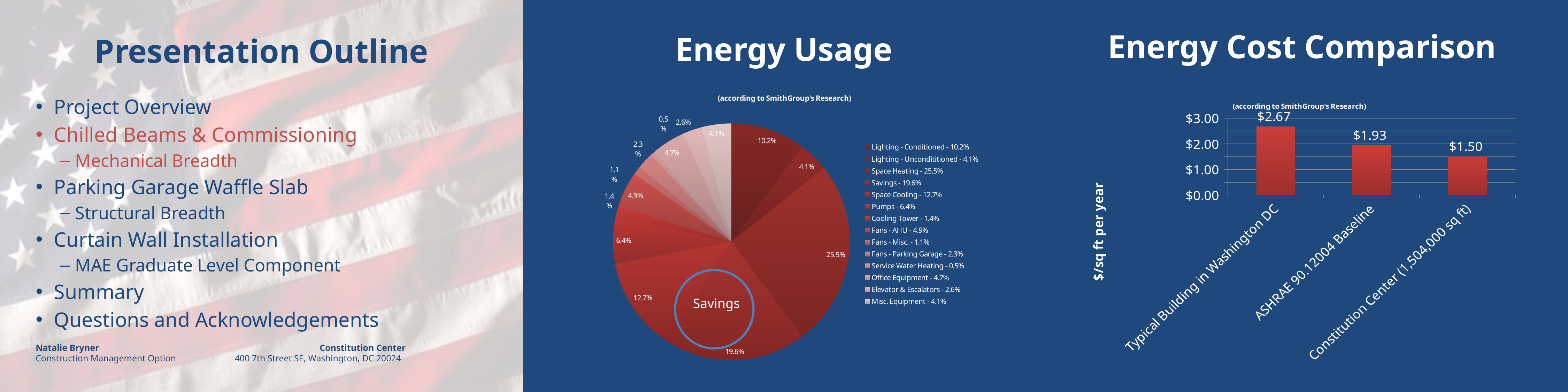
In the Energy Usage pie chart, which category has the smallest share? Service Water Heating In the Energy Cost Comparison chart, which category has the highest cost? Typical Building in Washington DC In the Energy Usage pie chart, what is the difference between the Space Heating share and the Space Cooling share? 12.8% In the Energy Cost Comparison chart, what is the difference between the Typical Building in Washington DC and the Constitution Center? $1.17 What type of chart is used on the Energy Cost Comparison slide? Bar chart In the Energy Usage pie chart, how many categories does the legend list? 14 In the Energy Usage pie chart, which category has the largest share? Space Heating In the Energy Cost Comparison chart, what is the value for the ASHRAE 90.1 2004 Baseline? $1.93 In the Energy Cost Comparison chart, what is the label on the vertical axis? $/sq ft per year In the Energy Usage pie chart, what share does Space Heating account for? 25.5% In the Energy Usage pie chart, which is larger: Space Cooling or Pumps? Space Cooling In the Energy Usage pie chart, what percentage is attributed to Savings? 19.6%